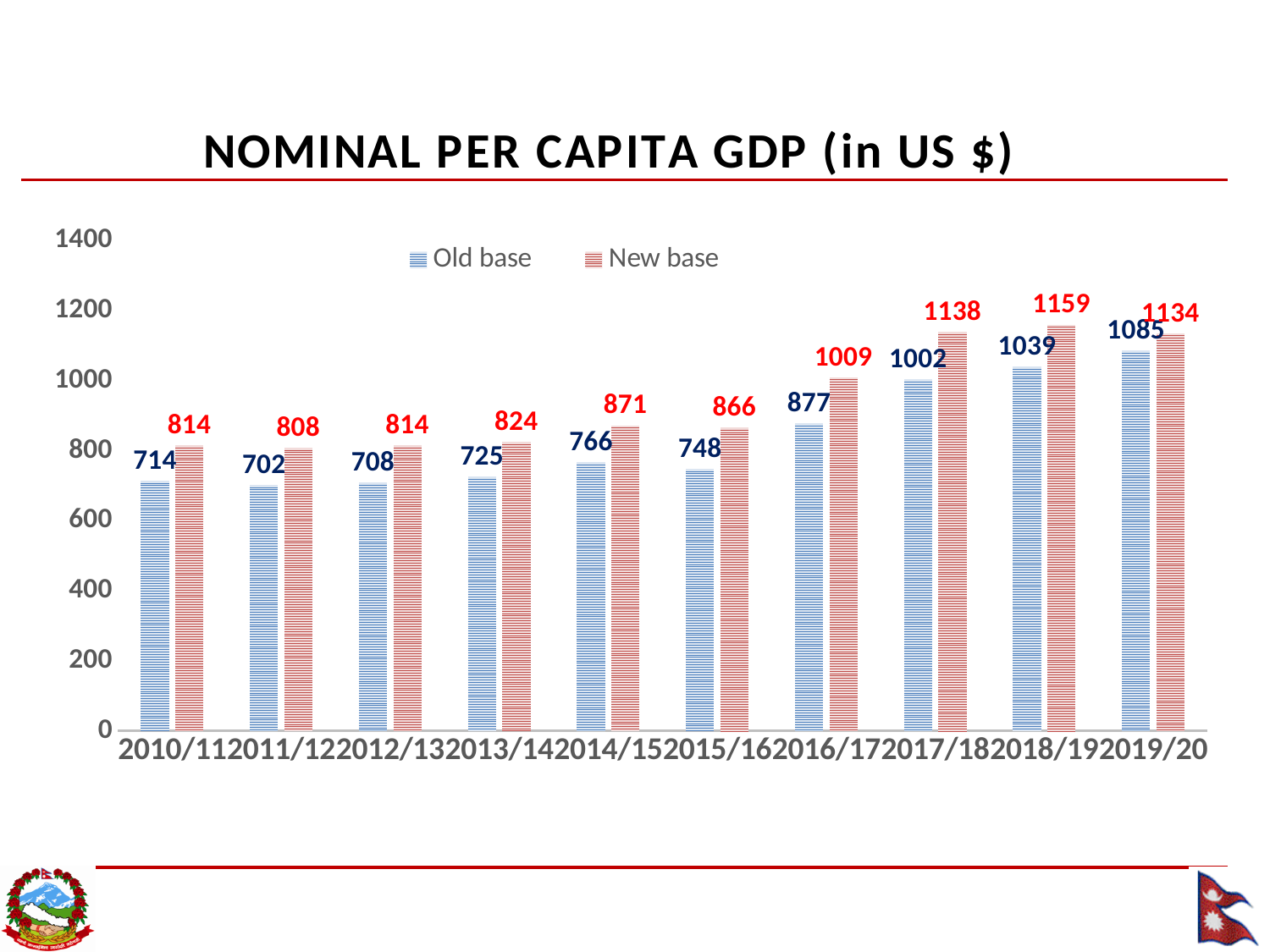
How many series does the legend list? 2 How many fiscal years are shown on the x axis? 10 What is the difference between the New base and Old base values for 2019/20? 49 Which year has the highest New base value? 2018/19 Which year has the lowest Old base value? 2011/12 What is the Old base value for 2016/17? 877 What kind of chart is shown on the slide? bar chart By how much did the Old base value increase from 2017/18 to 2018/19? 37 What colour are the New base bars? red Which is larger, the Old base value for 2013/14 or for 2015/16? 2015/16 What is the New base value for 2018/19? 1159 Do the Old base values rise or fall from 2016/17 to 2019/20? rise